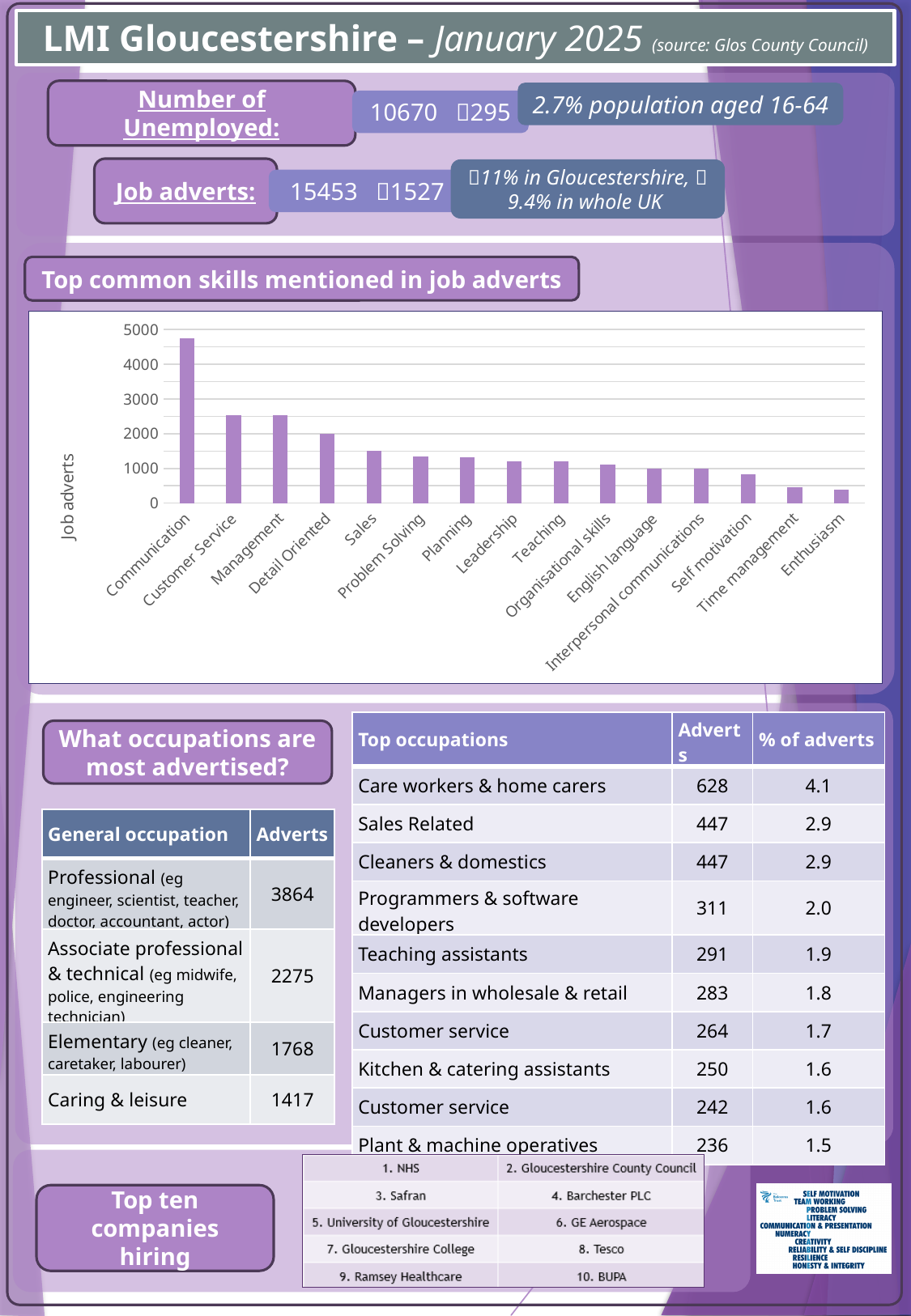
What kind of chart is used to show the top common skills mentioned in job adverts? bar chart Which has more job adverts, Sales or Time management? Sales Which skill has the lowest number of job adverts in the chart? Enthusiasm Is the value for Customer Service greater or less than 2000? greater Which skill has the highest number of job adverts in the chart? Communication Is the value for Sales greater or less than 2000? less How many skills are plotted in the 'Top common skills mentioned in job adverts' chart? 15 Do the values in the skills chart generally rise or fall from left to right? fall Is the value for Communication greater or less than 4000? greater Which has more job adverts, Communication or Customer Service? Communication What is the label on the vertical axis of the skills chart? Job adverts